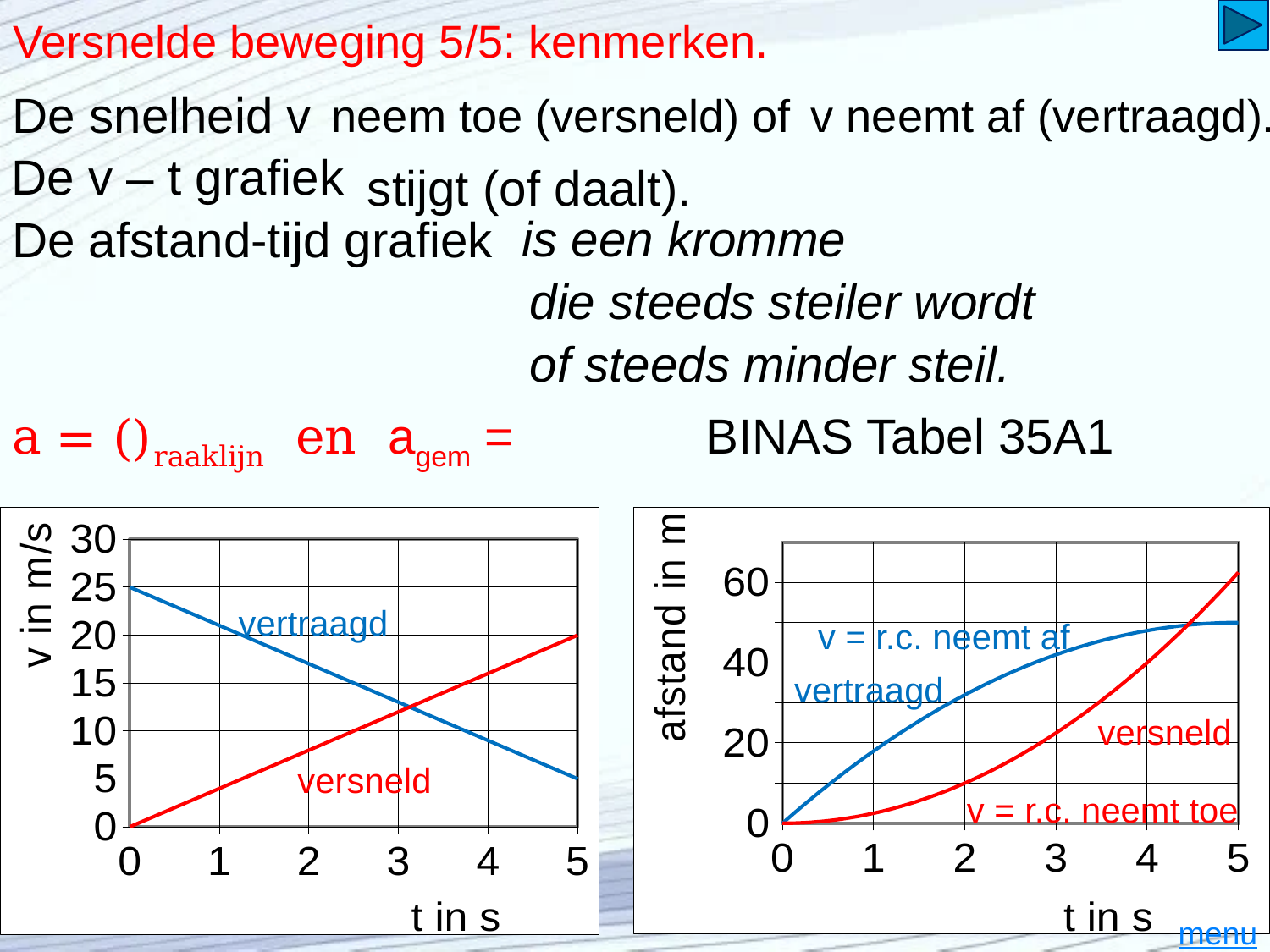
What kind of chart is the right chart (afstand in m against t in s)? line chart In the left chart (v in m/s), what is the value of the 'vertraagd' line at t = 5? 5 In the left chart (v in m/s), does the 'vertraagd' line rise or fall as t increases? fall In the right chart (afstand in m), is the value of the 'vertraagd' curve at t = 5 greater or less than 40? greater In the left chart (v in m/s), what is the difference between the 'vertraagd' and 'versneld' values at t = 0? 25 In the left chart (v in m/s), does the 'versneld' line rise or fall as t increases? rise In the left chart (v in m/s), what is the value of the 'vertraagd' line at t = 0? 25 In the left chart (v in m/s), what is the value of the 'versneld' line at t = 5? 20 In the right chart (afstand in m), is the value of the 'versneld' curve at t = 5 greater or less than 60? greater What kind of chart is the left chart (v in m/s against t in s)? line chart In the left chart (v in m/s), which line has the larger value at t = 5, 'vertraagd' or 'versneld'? versneld How many lines are plotted in the right chart (afstand in m)? 2